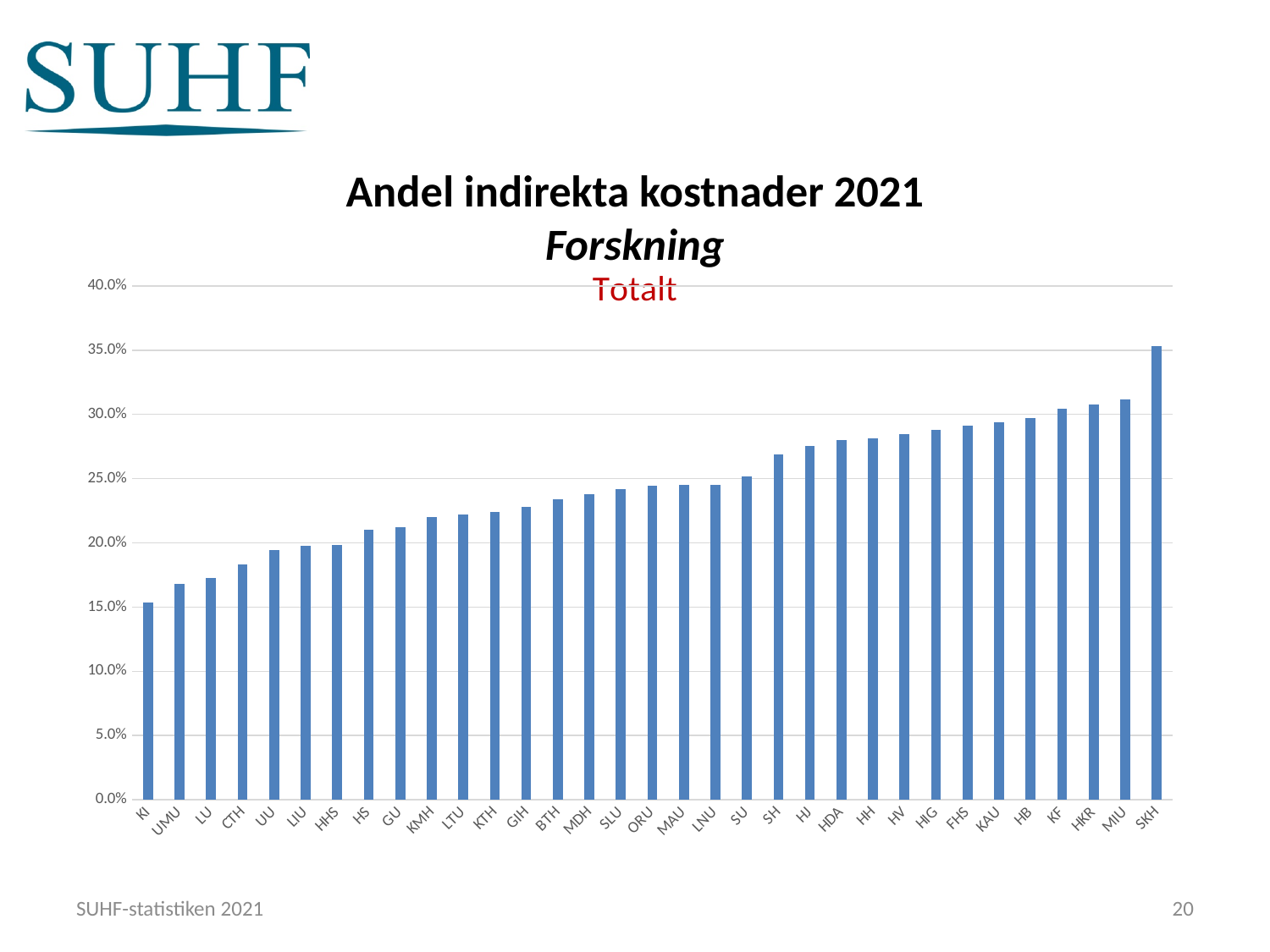
What kind of chart is shown on the slide? bar chart Is the value for UU greater or less than 20.0%? less Do the values rise or fall moving from left to right along the x axis? rise Is the value for SKH greater or less than 30.0%? greater Which has the larger value, LU or HJ? HJ Is the value for SH greater or less than 25.0%? greater Which category has the lowest value in the chart? KI How many categories are shown along the x axis? 33 What is the title of the chart? Andel indirekta kostnader 2021 Forskning Which category has the highest value in the chart? SKH Which has the larger value, GU or HV? HV